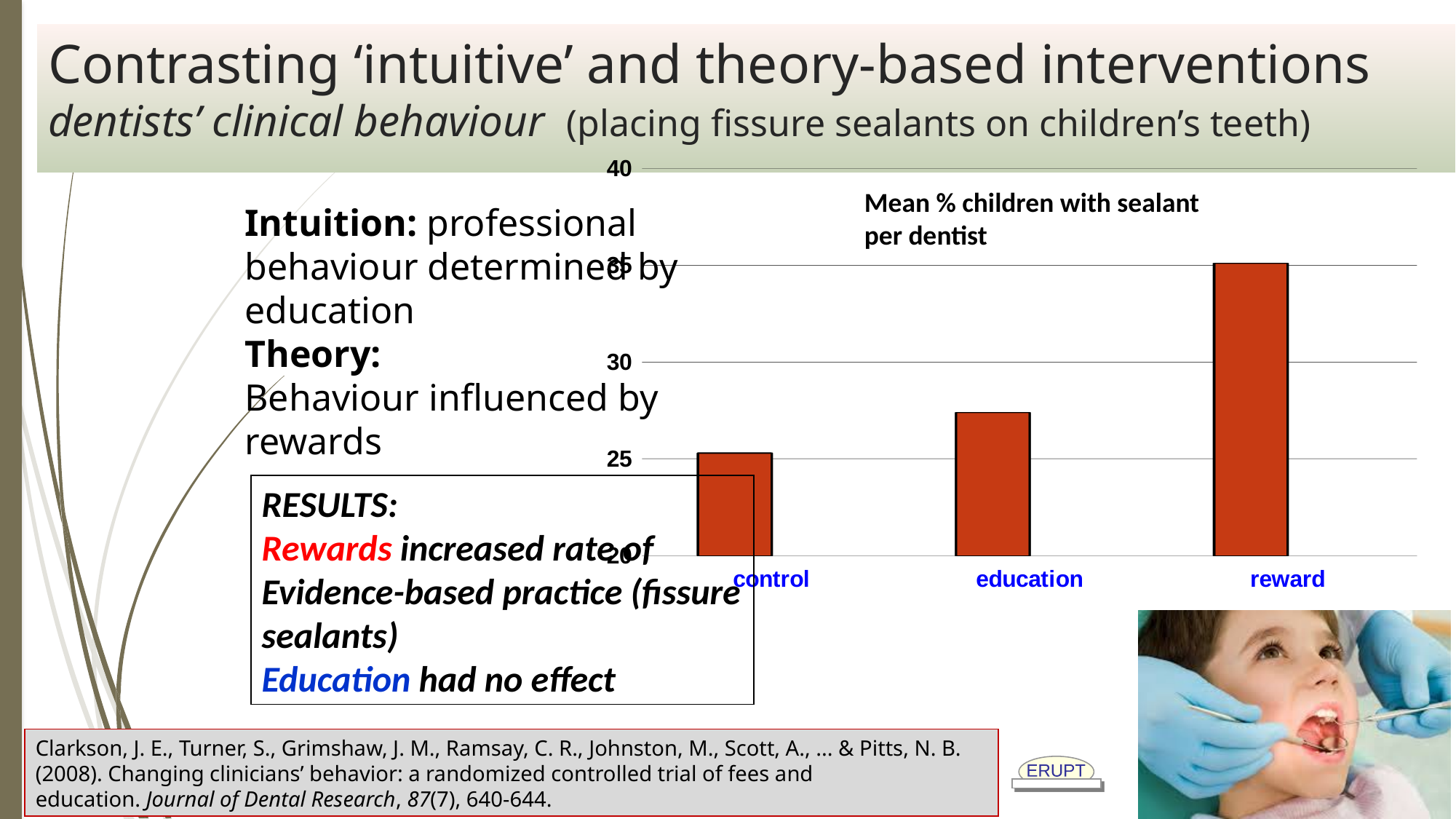
What is the title of the chart? Mean % children with sealant per dentist Which category has the highest mean % children with sealant per dentist? reward Do the values rise or fall moving from control to reward along the x axis? rise Which is larger, the value for reward or the value for education? reward Is the value for education greater or less than 30? less Is the value for reward greater or less than 40? less Which category has the lowest mean % children with sealant per dentist? control Is the value for control greater or less than 30? less How many categories are shown on the x axis of the chart? 3 What kind of chart is shown on the slide? bar chart Which is larger, the value for education or the value for control? education